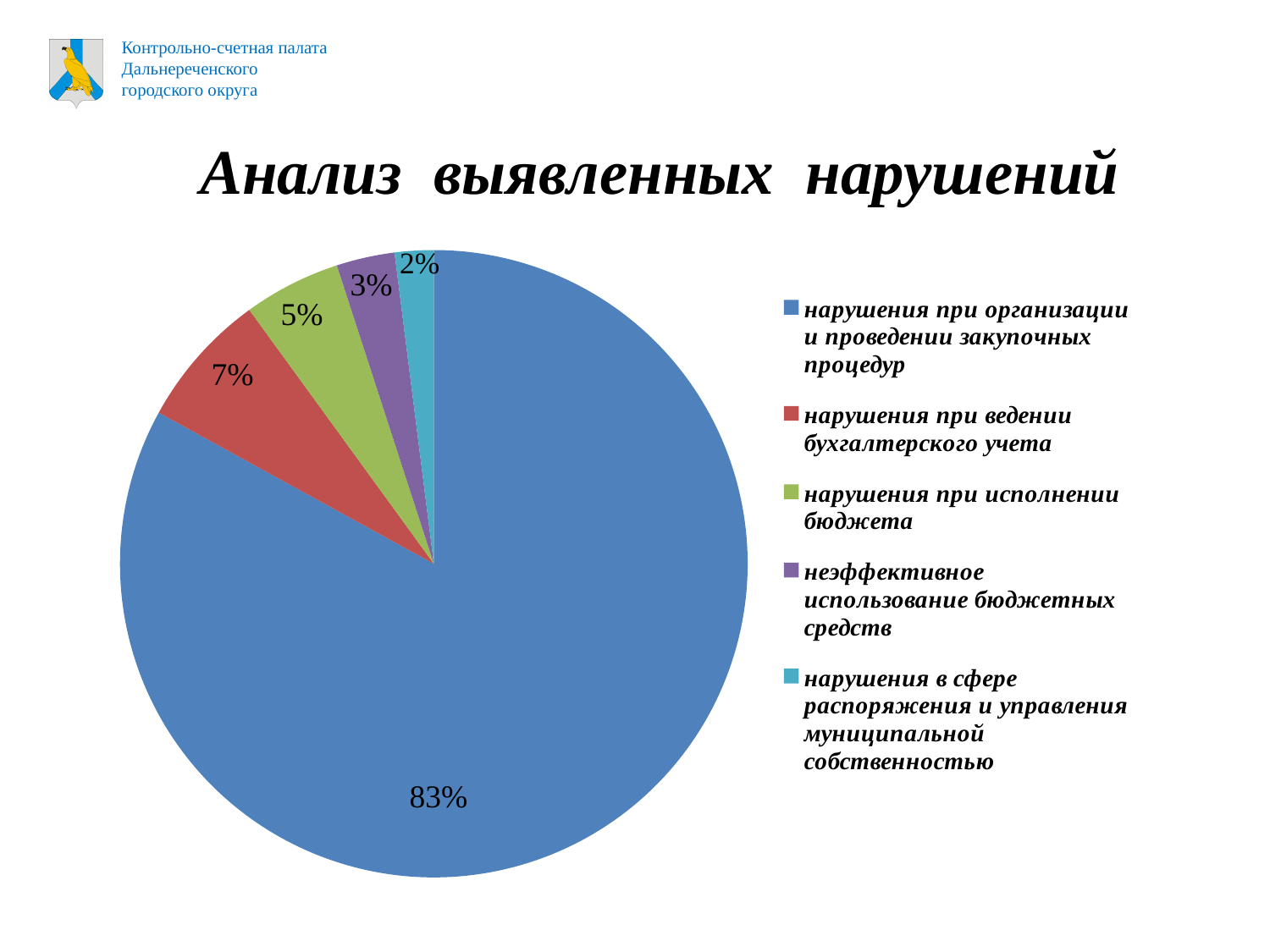
Which is larger: the slice for 'нарушения при исполнении бюджета' or the slice for 'неэффективное использование бюджетных средств'? нарушения при исполнении бюджета What type of chart is shown on the slide? pie chart Which category has the largest slice of the pie? нарушения при организации и проведении закупочных процедур What share of the pie is labelled for 'нарушения при организации и проведении закупочных процедур'? 83% What share of the pie is labelled for 'неэффективное использование бюджетных средств'? 3% Which category has the smallest slice of the pie? нарушения в сфере распоряжения и управления муниципальной собственностью What share of the pie is labelled for 'нарушения при исполнении бюджета'? 5% How many categories does the pie chart show? 5 What is the title of the chart on the slide? Анализ выявленных нарушений What is the difference in percentage points between 'нарушения при ведении бухгалтерского учета' and 'нарушения при исполнении бюджета'? 2 percentage points